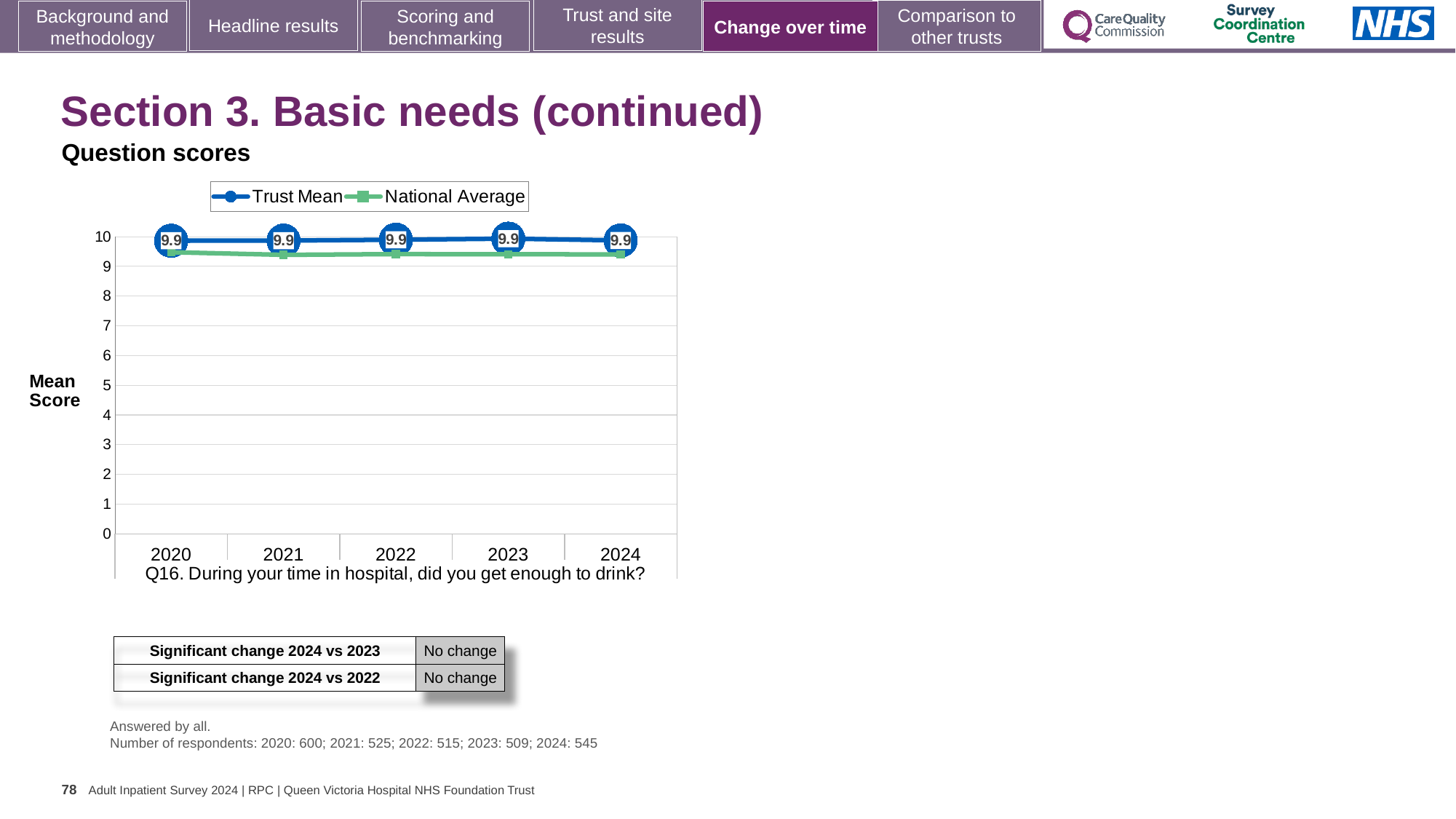
In 2021, which is larger: the Trust Mean or the National Average? Trust Mean What is the difference between the Trust Mean in 2024 and the Trust Mean in 2020? 0 How many years are plotted on the x axis? 5 Is the National Average value for 2020 greater or less than 8? greater In 2024, which is larger: the Trust Mean or the National Average? Trust Mean How many series does the legend list? 2 What kind of chart is shown on the slide? Line chart What is the Trust Mean value for 2020? 9.9 What is the Trust Mean value for 2022? 9.9 Is the National Average value for 2024 greater or less than 9? greater What is the Trust Mean value for 2024? 9.9 Does the Trust Mean rise, fall or stay the same from 2020 to 2024? Stays the same